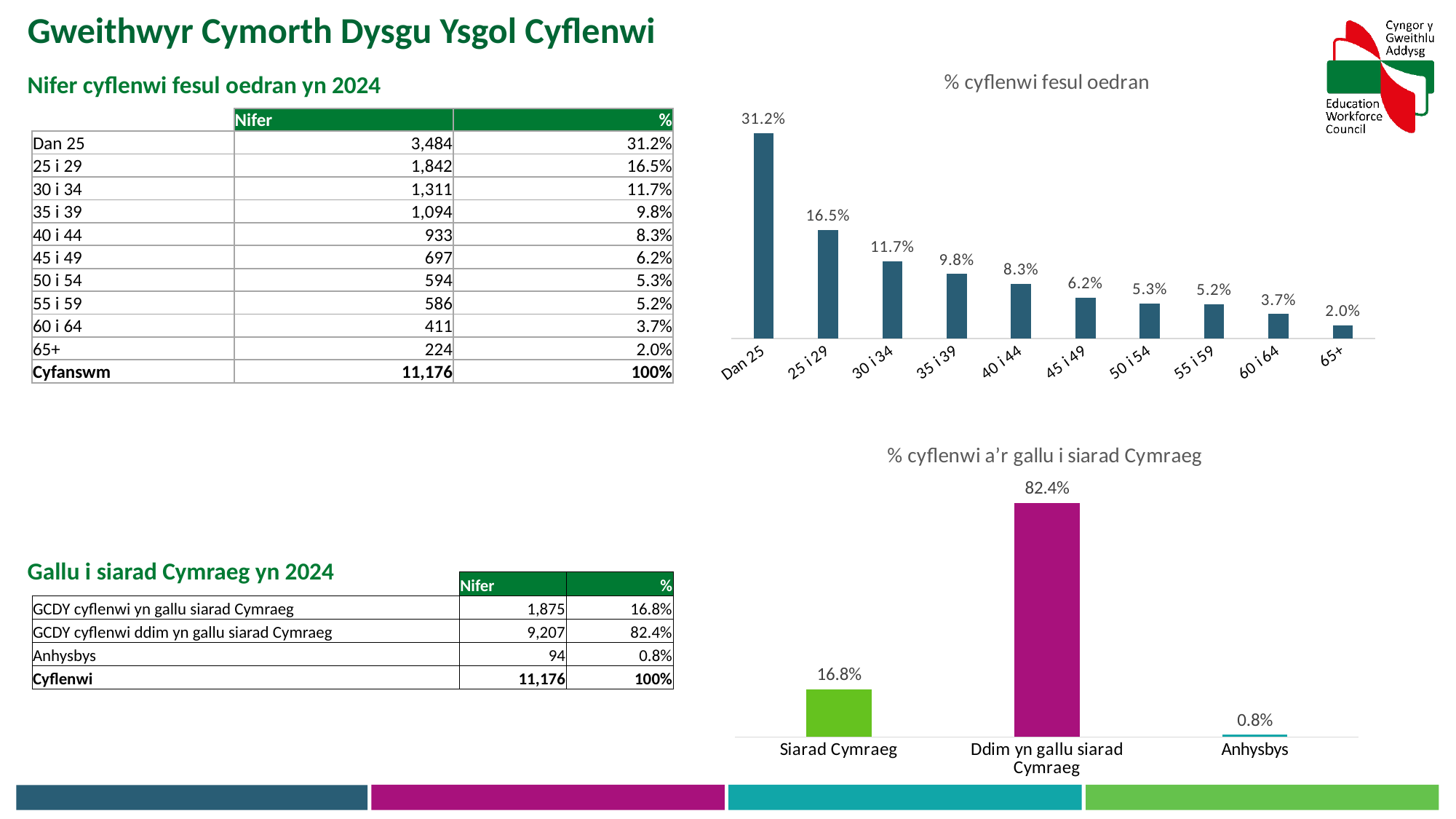
In the '% cyflenwi fesul oedran' chart, what is the value for 'Dan 25'? 31.2% In the '% cyflenwi fesul oedran' chart, which age category has the highest value? Dan 25 In the '% cyflenwi fesul oedran' chart, which age category has the lowest value? 65+ In the '% cyflenwi a'r gallu i siarad Cymraeg' chart, what colour is the bar for 'Ddim yn gallu siarad Cymraeg'? magenta In the '% cyflenwi a'r gallu i siarad Cymraeg' chart, what is the value for 'Siarad Cymraeg'? 16.8% In the '% cyflenwi fesul oedran' chart, how many age categories are shown? 10 In the '% cyflenwi fesul oedran' chart, do the values rise or fall from left to right along the x axis? fall In the '% cyflenwi fesul oedran' chart, what is the value for '40 i 44'? 8.3% In the '% cyflenwi a'r gallu i siarad Cymraeg' chart, what is the difference between 'Ddim yn gallu siarad Cymraeg' and 'Siarad Cymraeg'? 65.6% What kind of chart is the '% cyflenwi fesul oedran' chart? bar chart In the '% cyflenwi a'r gallu i siarad Cymraeg' chart, which category has the highest value? Ddim yn gallu siarad Cymraeg In the '% cyflenwi fesul oedran' chart, what is the difference between the values for '25 i 29' and '30 i 34'? 4.8%